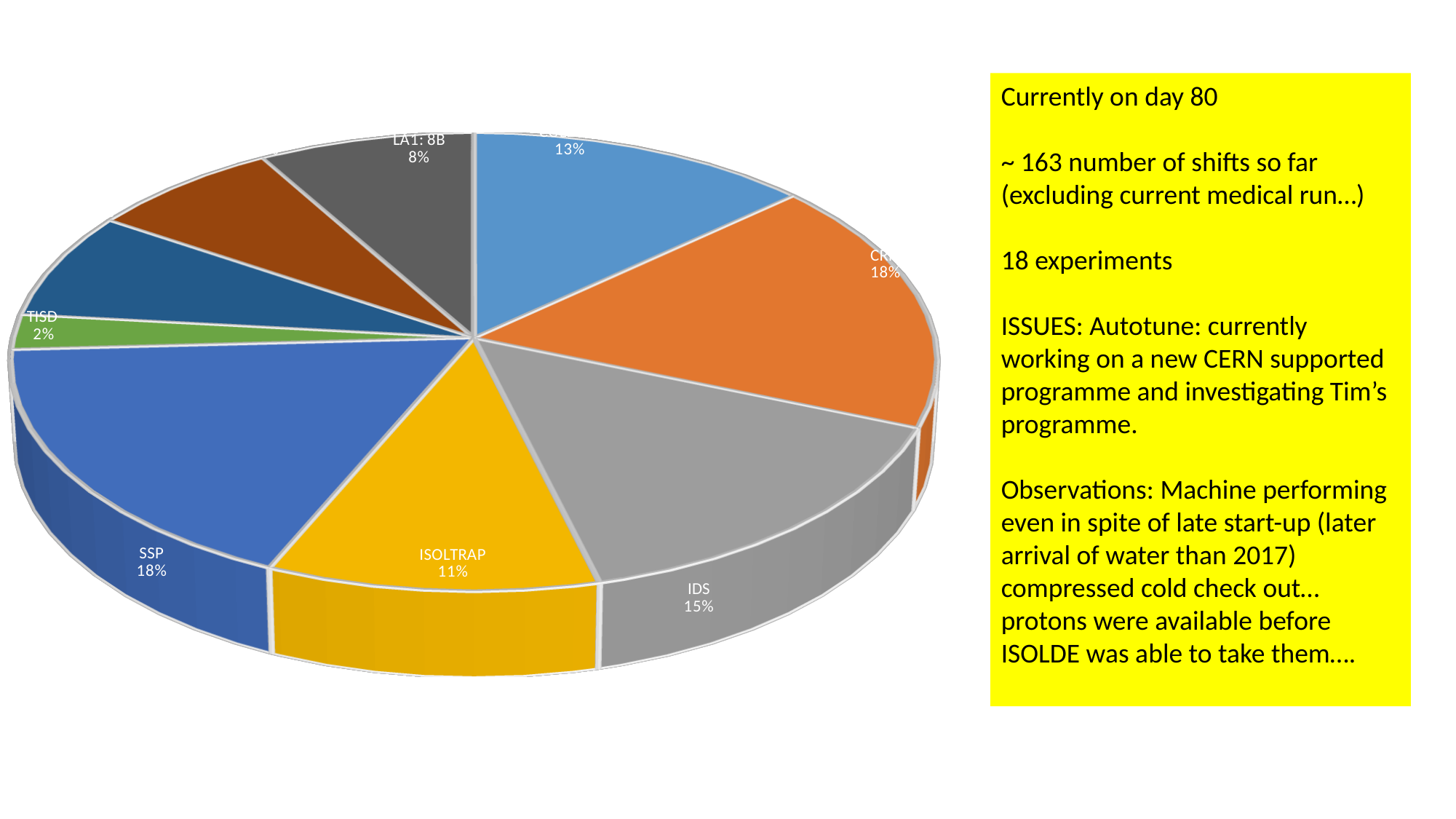
Which has the larger share, SSP or IDS? SSP What share of the pie does TISD have? 2% What share of the pie does ISOLTRAP have? 11% What kind of chart is shown on the slide? pie chart Which labelled slice has the smallest share of the pie? TISD What share of the pie does IDS have? 15% How many percentage points larger is the IDS share than the TISD share? 13 percentage points What share of the pie does LA1: 8B have? 8% How many slices does the pie chart have? 9 What share of the pie does SSP have? 18% Which has the larger share, IDS or ISOLTRAP? IDS How many percentage points larger is the SSP share than the ISOLTRAP share? 7 percentage points